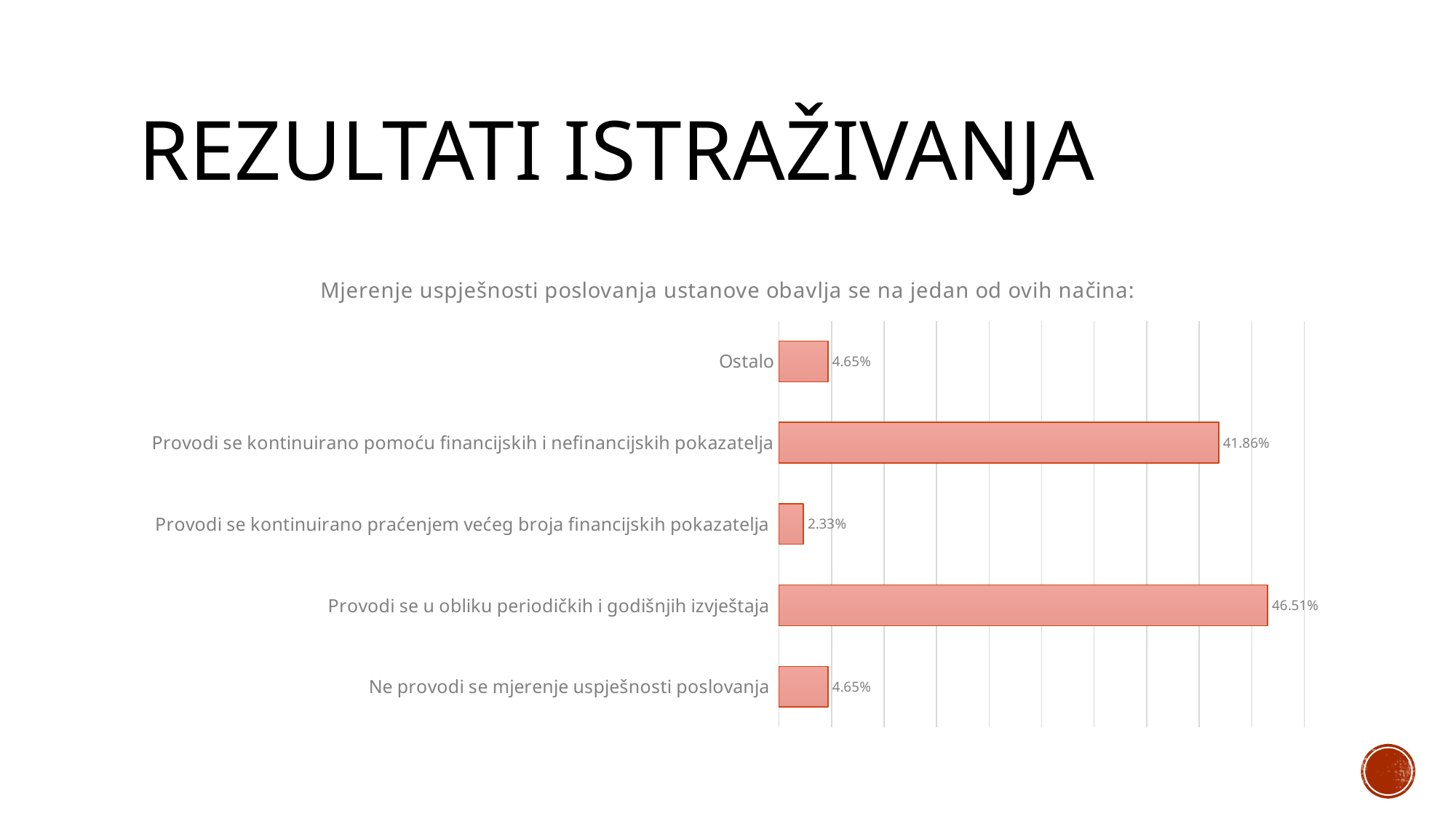
What is the value for 'Provodi se kontinuirano praćenjem većeg broja financijskih pokazatelja'? 2.33% How many categories are shown in the chart? 5 What is the difference between the values for 'Ostalo' and 'Provodi se kontinuirano praćenjem većeg broja financijskih pokazatelja'? 2.32% Which is larger: the value for 'Ne provodi se mjerenje uspješnosti poslovanja' or the value for 'Provodi se kontinuirano praćenjem većeg broja financijskih pokazatelja'? Ne provodi se mjerenje uspješnosti poslovanja What is the title of the chart? Mjerenje uspješnosti poslovanja ustanove obavlja se na jedan od ovih načina: What is the value for 'Provodi se u obliku periodičkih i godišnjih izvještaja'? 46.51% Which category has the highest value? Provodi se u obliku periodičkih i godišnjih izvještaja What kind of chart is shown on the slide? Bar chart What is the value for 'Ostalo'? 4.65% What is the difference between the values for 'Provodi se u obliku periodičkih i godišnjih izvještaja' and 'Provodi se kontinuirano pomoću financijskih i nefinancijskih pokazatelja'? 4.65% Which category has the lowest value? Provodi se kontinuirano praćenjem većeg broja financijskih pokazatelja What is the value for 'Provodi se kontinuirano pomoću financijskih i nefinancijskih pokazatelja'? 41.86%